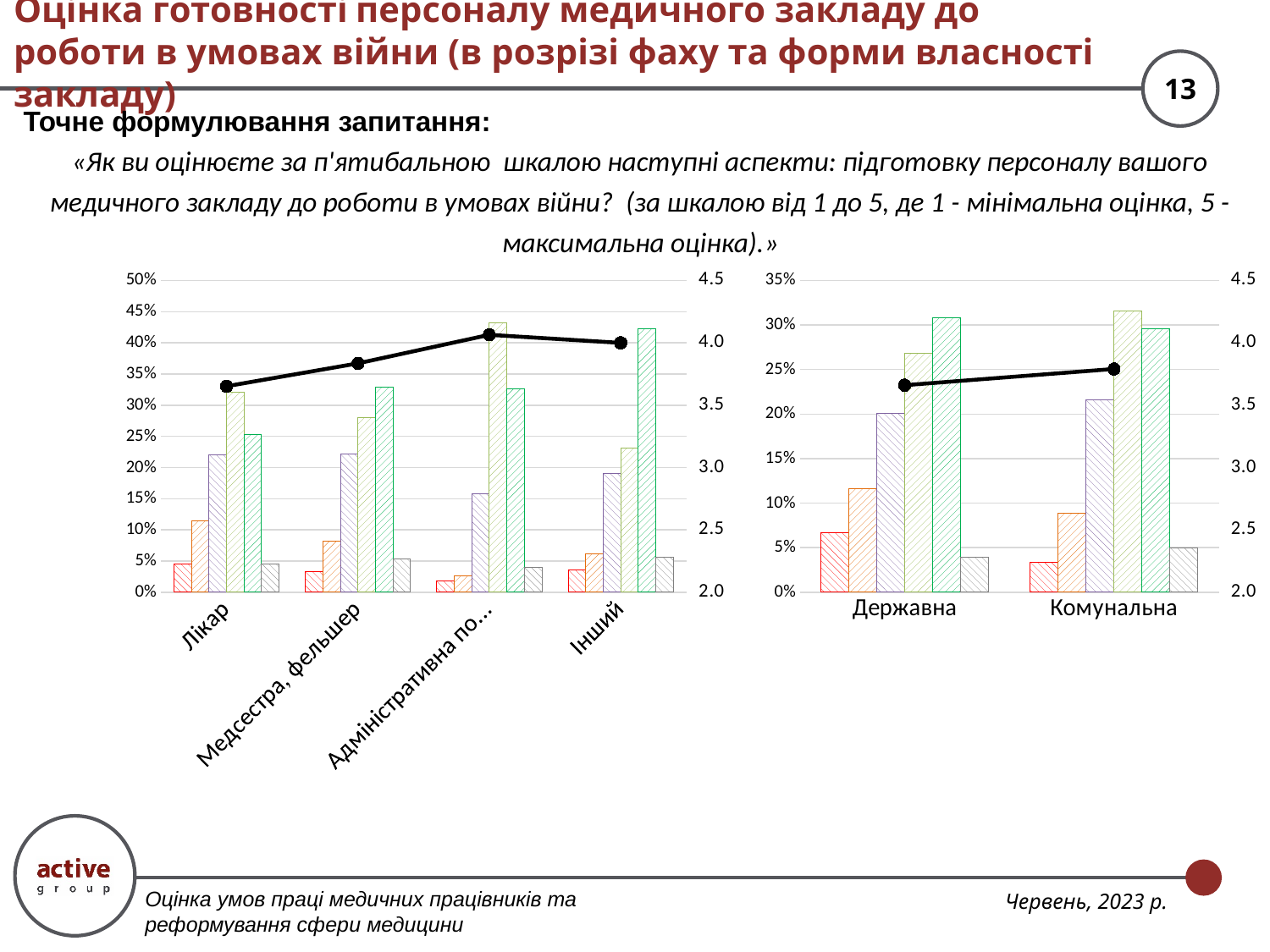
What kind of chart is the right chart? Bar chart with a line On the left chart, which category has the higher black line value, Лікар or Адміністративна по...? Адміністративна по... On the left chart, is the black line value for Лікар greater or less than 3.5 on the right-hand axis? greater On the right chart, is the black line value for Комунальна greater or less than 4.0 on the right-hand axis? less How many categories are shown on the x axis of the right chart? 2 On the left chart, is the tallest bar for Інший greater or less than 40%? greater On the left chart, does the black line rise or fall from Лікар to Адміністративна по...? rise On the right chart, does the black line rise or fall from Державна to Комунальна? rise How many categories are shown on the x axis of the left chart? 4 On the right chart, which category has the larger red bar, Державна or Комунальна? Державна